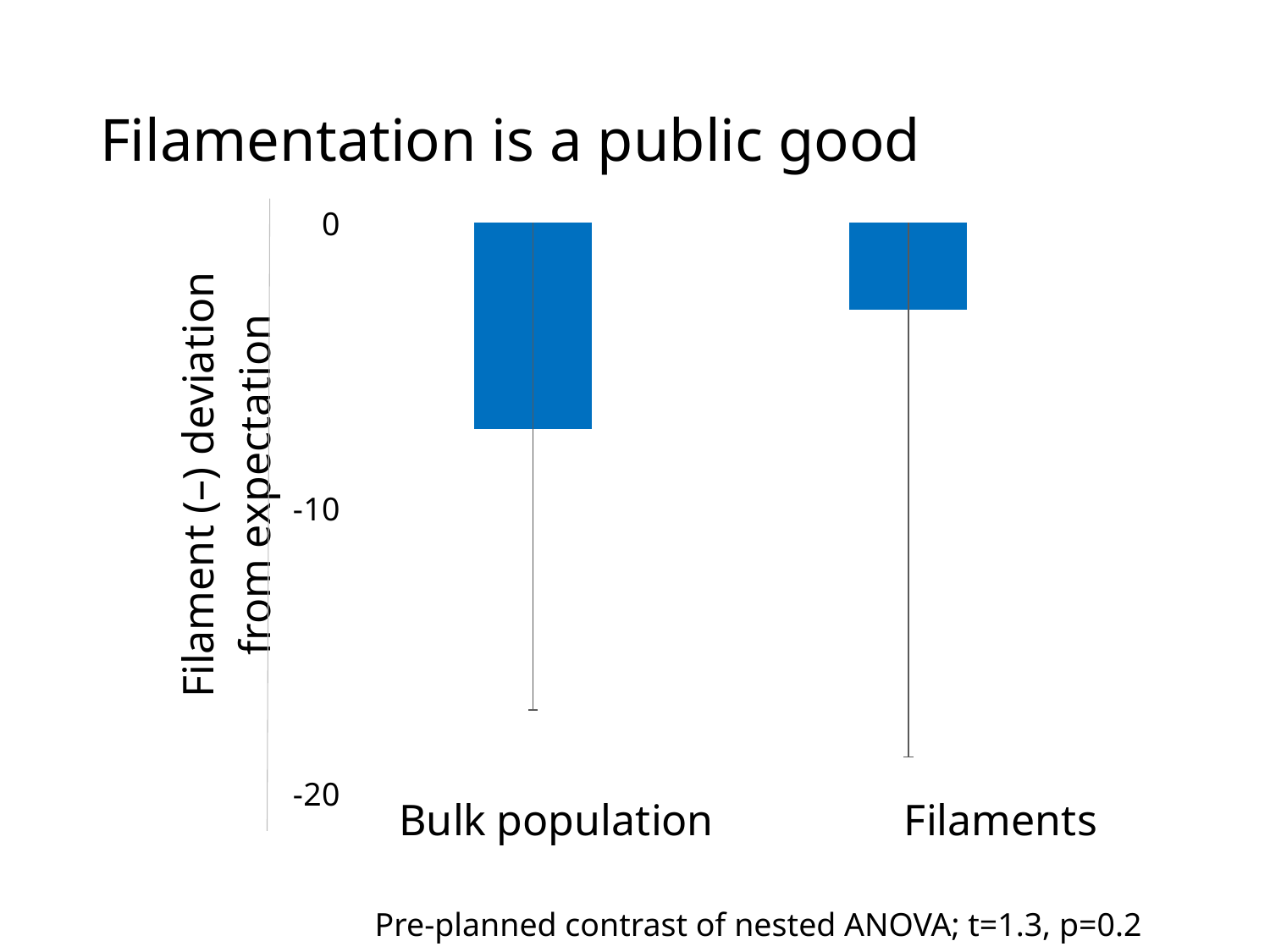
What is the title of the slide containing the chart? Filamentation is a public good Which category has the highest value (closest to 0)? Filaments What is the label on the y axis of the chart? Filament (–) deviation from expectation Is the value for Filaments greater or less than 0? less Is the value for Bulk population greater or less than -10? greater Which category has the lowest (most negative) value? Bulk population Is the value for Filaments greater or less than -10? greater What kind of chart is shown on the slide? bar chart How many categories are plotted on the x axis? 2 Which bar extends further below zero, Bulk population or Filaments? Bulk population